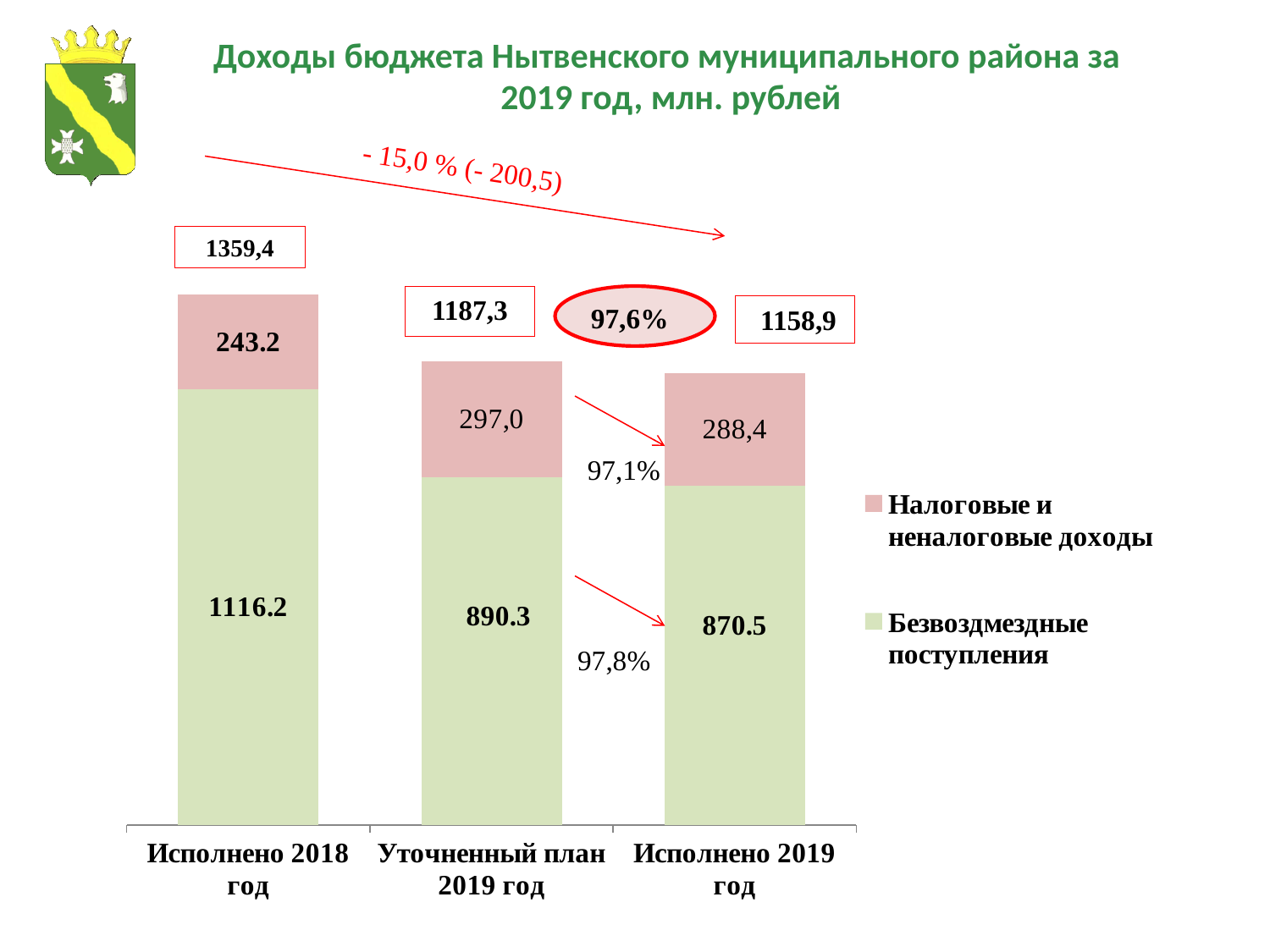
What is the total of the stacked bar for Исполнено 2019 год? 1158,9 Which is larger: Налоговые и неналоговые доходы for Уточненный план 2019 год or for Исполнено 2019 год? Уточненный план 2019 год How many series does the legend list? 2 What is the difference between Безвозмездные поступления for Исполнено 2018 год and Исполнено 2019 год? 245.7 What is the value of Безвозмездные поступления for Исполнено 2018 год? 1116.2 How many categories are shown on the x axis of the chart? 3 Which category has the highest value for Безвозмездные поступления? Исполнено 2018 год What type of chart is shown on the slide? Stacked bar chart What is the value of Налоговые и неналоговые доходы for Уточненный план 2019 год? 297,0 Which category has the lowest value for Налоговые и неналоговые доходы? Исполнено 2018 год What is the value of Налоговые и неналоговые доходы for Исполнено 2019 год? 288,4 What is the total of the stacked bar for Уточненный план 2019 год? 1187,3